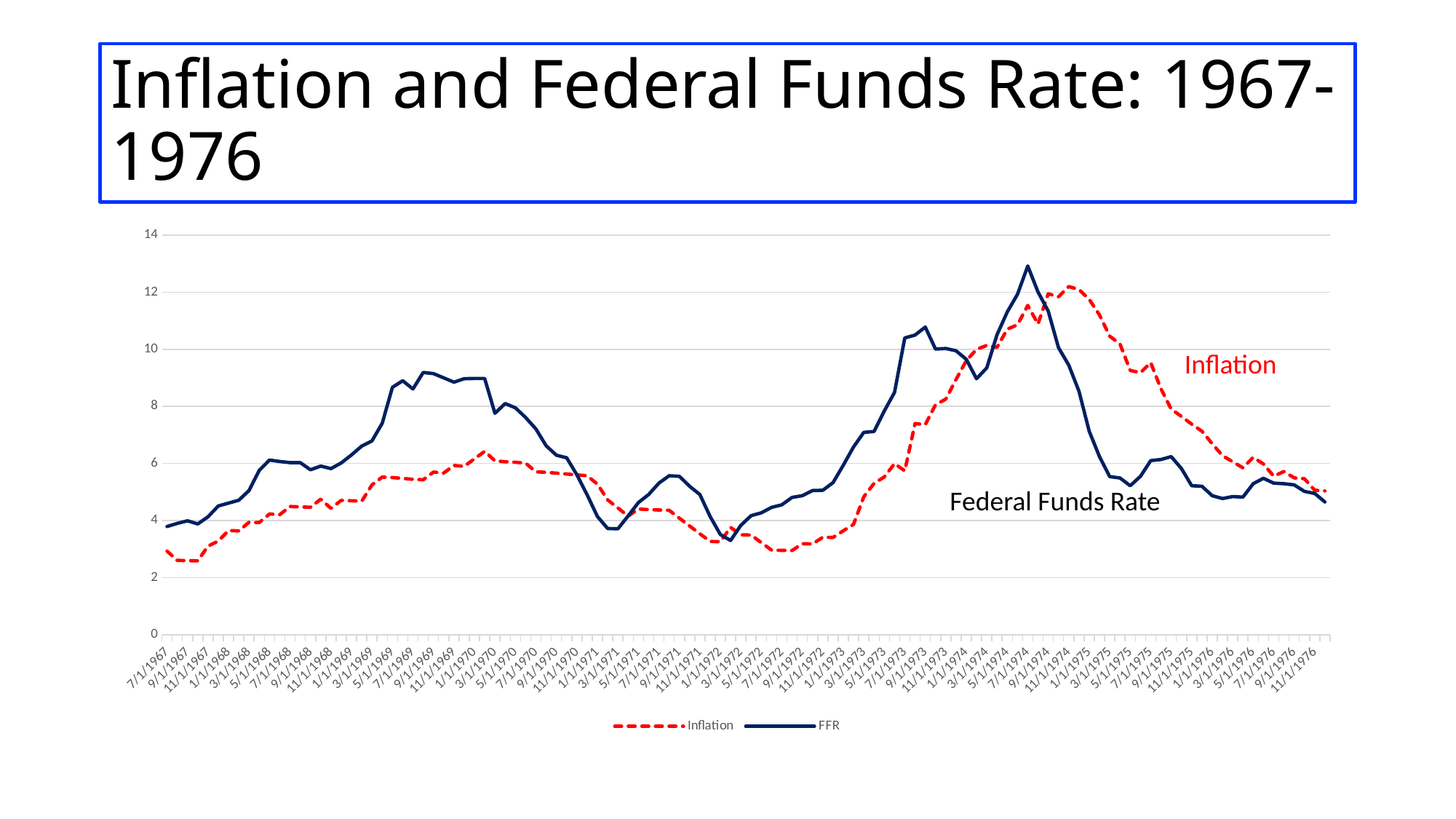
What are the two series named in the legend? Inflation and FFR What is the title of the slide's chart? Inflation and Federal Funds Rate: 1967-1976 Is the FFR value at 9/1/1969 greater or less than 8? greater What kind of chart is shown on the slide? Line chart Does the FFR series rise or fall between 7/1/1974 and 5/1/1975? Fall At 9/1/1969, which series has the higher value, Inflation or FFR? FFR Is the FFR value at 11/1/1976 greater or less than 6? less Is the FFR value at 7/1/1974 greater or less than 12? greater How many series does the legend list? 2 At 1/1/1975, which series has the higher value, Inflation or FFR? Inflation